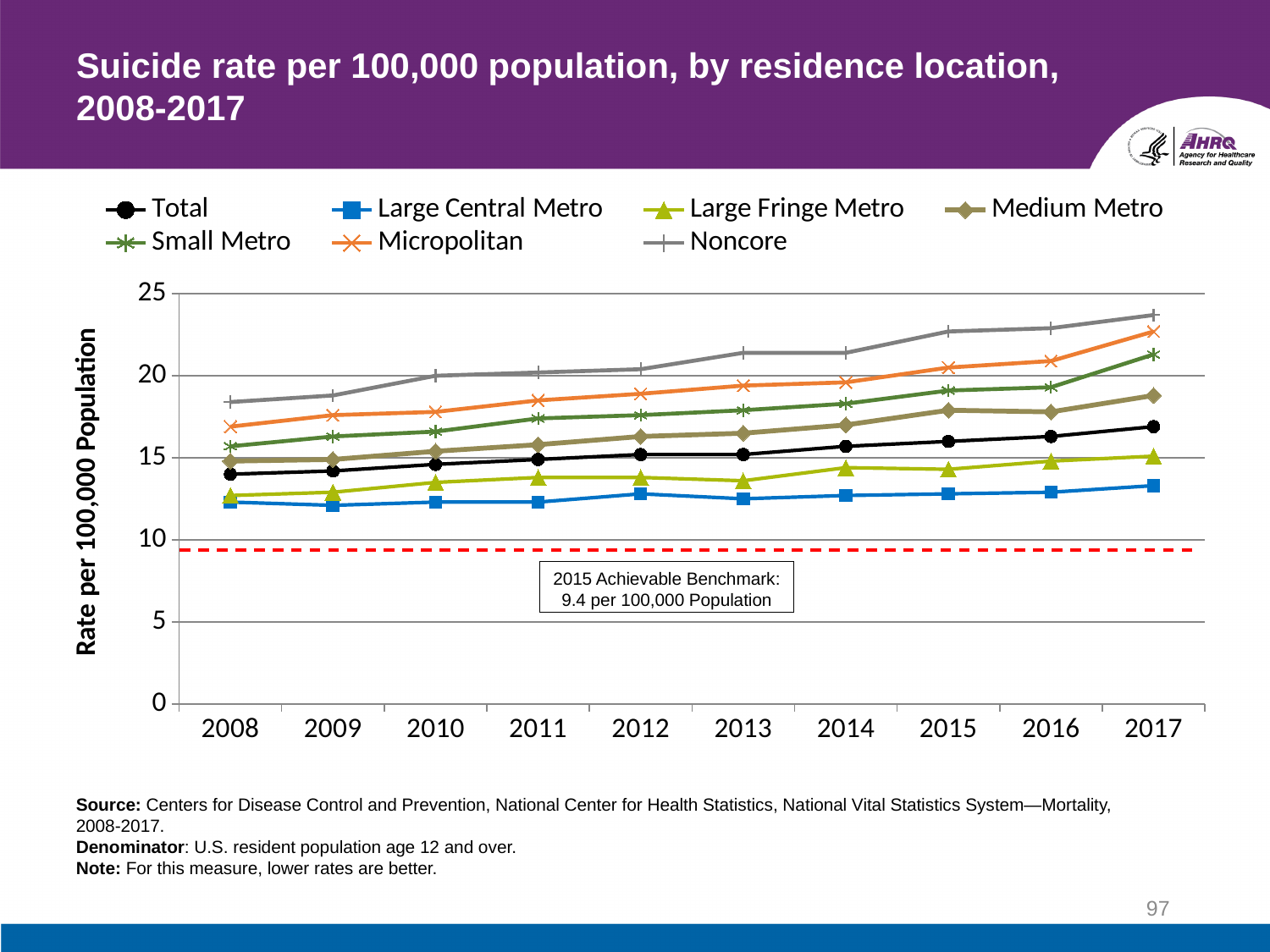
What is the label of the y axis? Rate per 100,000 Population Is the value for Large Central Metro in 2008 greater or less than 15? less Is the value for Noncore in 2017 greater or less than 20? greater How many years are plotted along the x axis? 10 How many series does the legend list? 7 Does the Noncore suicide rate rise or fall from 2008 to 2017? Rise What is the 2015 Achievable Benchmark shown on the chart? 9.4 per 100,000 Population Which residence location has the highest suicide rate in 2017? Noncore What kind of chart is shown on the slide? Line chart Which residence location has the lowest suicide rate in 2017? Large Central Metro In 2017, which is larger: the Micropolitan rate or the Medium Metro rate? Micropolitan Is the value for Total in 2017 greater or less than 15? greater